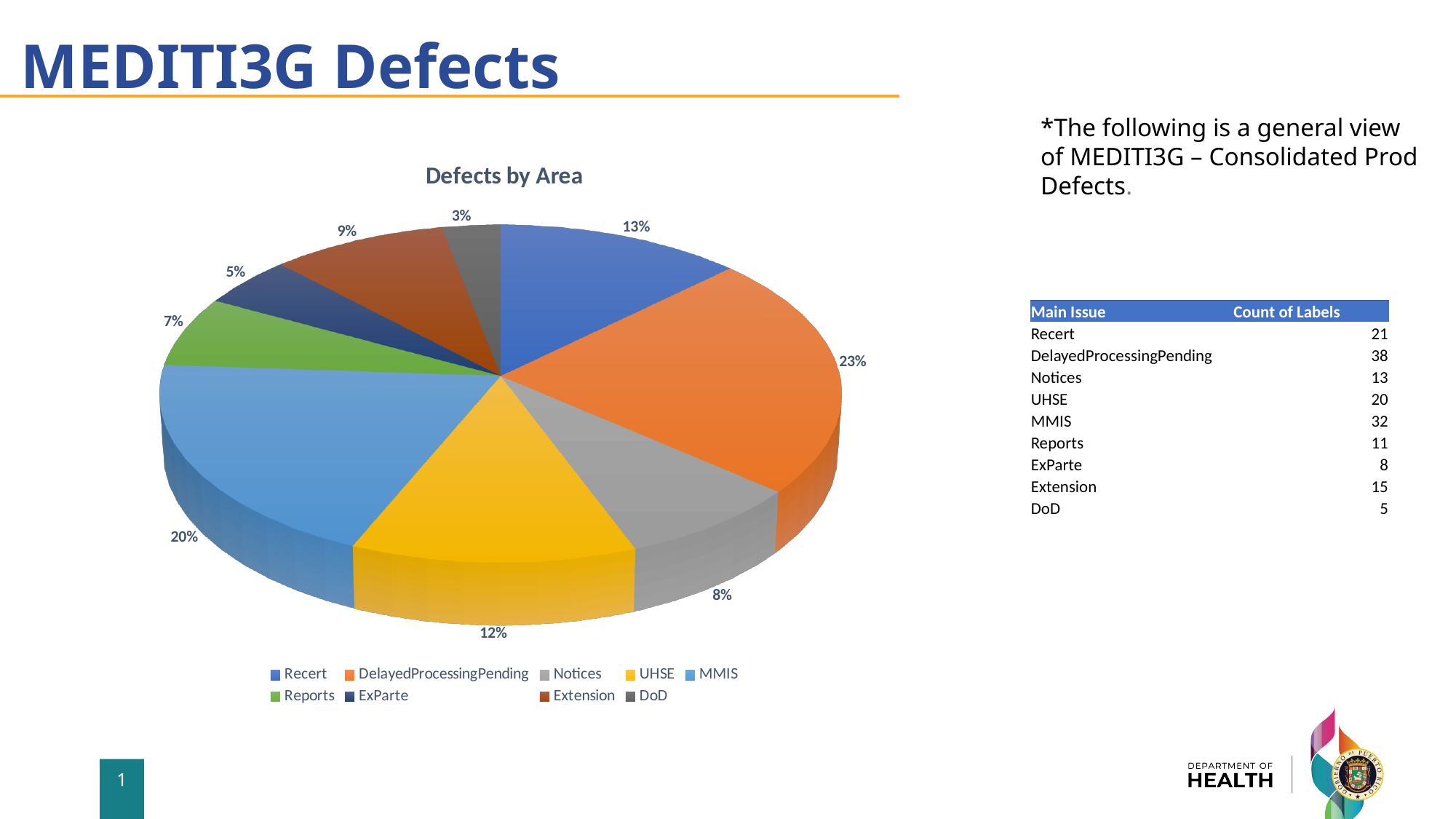
What percentage is shown for UHSE in the pie chart? 12% How many slices does the pie chart have? 9 Which has a larger share in the pie chart, Notices or Reports? Notices What percentage is shown for Extension in the pie chart? 9% What kind of chart is shown on the slide? pie chart What percentage is shown for Recert in the pie chart? 13% Which has a larger share in the pie chart, ExParte or Extension? Extension What is the difference in percentage points between DelayedProcessingPending and MMIS in the pie chart? 3 What is the title of the chart? Defects by Area What share of defects does MMIS account for in the pie chart? 20% Which area has the largest share of defects in the pie chart? DelayedProcessingPending Which area has the smallest share of defects in the pie chart? DoD